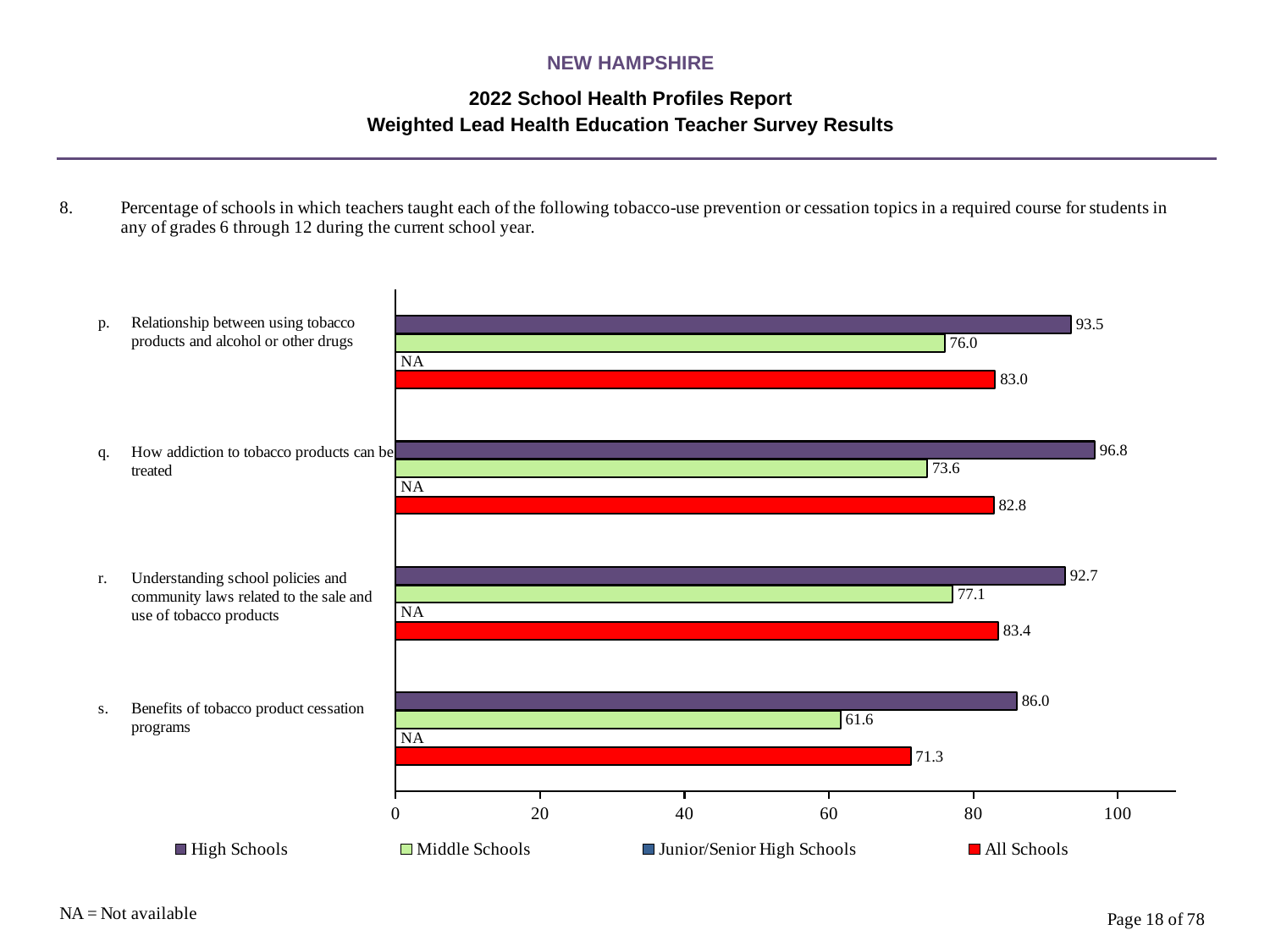
Which is larger for 'Relationship between using tobacco products and alcohol or other drugs': the Middle Schools value or the All Schools value? All Schools What colour are the All Schools bars? Red Which topic has the highest High Schools value? How addiction to tobacco products can be treated What is the High Schools value for 'How addiction to tobacco products can be treated'? 96.8 How many topics (categories) are shown on the chart? 4 How many series does the legend list? 4 What is shown for Junior/Senior High Schools for 'Relationship between using tobacco products and alcohol or other drugs'? NA What is the Middle Schools value for 'Benefits of tobacco product cessation programs'? 61.6 Which topic has the lowest Middle Schools value? Benefits of tobacco product cessation programs What is the difference between the High Schools and Middle Schools values for 'Benefits of tobacco product cessation programs'? 24.4 What is the All Schools value for 'Understanding school policies and community laws related to the sale and use of tobacco products'? 83.4 What kind of chart is shown on the slide? Bar chart